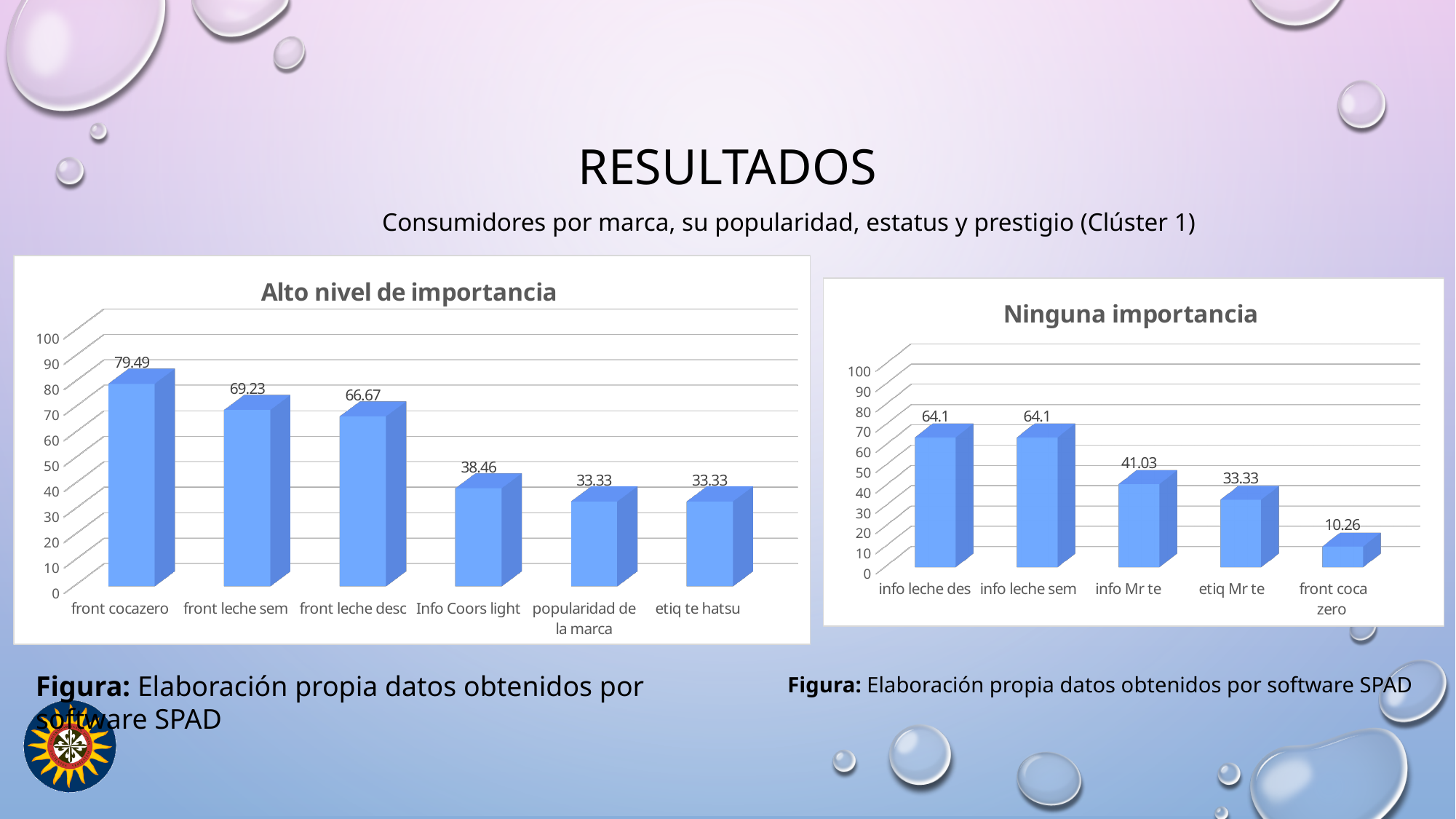
In the 'Alto nivel de importancia' chart, do the values rise or fall from left to right? fall In the 'Ninguna importancia' chart, how many categories are shown? 5 In the 'Alto nivel de importancia' chart, what is the value for front cocazero? 79.49 In the 'Ninguna importancia' chart, which is larger, etiq Mr te or front coca zero? etiq Mr te In the 'Alto nivel de importancia' chart, what is the value for Info Coors light? 38.46 In the 'Ninguna importancia' chart, what is the difference between info leche des and front coca zero? 53.84 What type of chart is the 'Ninguna importancia' chart? bar chart In the 'Alto nivel de importancia' chart, which category has the highest value? front cocazero In the 'Ninguna importancia' chart, what is the value for info Mr te? 41.03 In the 'Ninguna importancia' chart, which category has the lowest value? front coca zero In the 'Alto nivel de importancia' chart, what is the difference between front leche sem and front leche desc? 2.56 In the 'Alto nivel de importancia' chart, how many categories are shown? 6